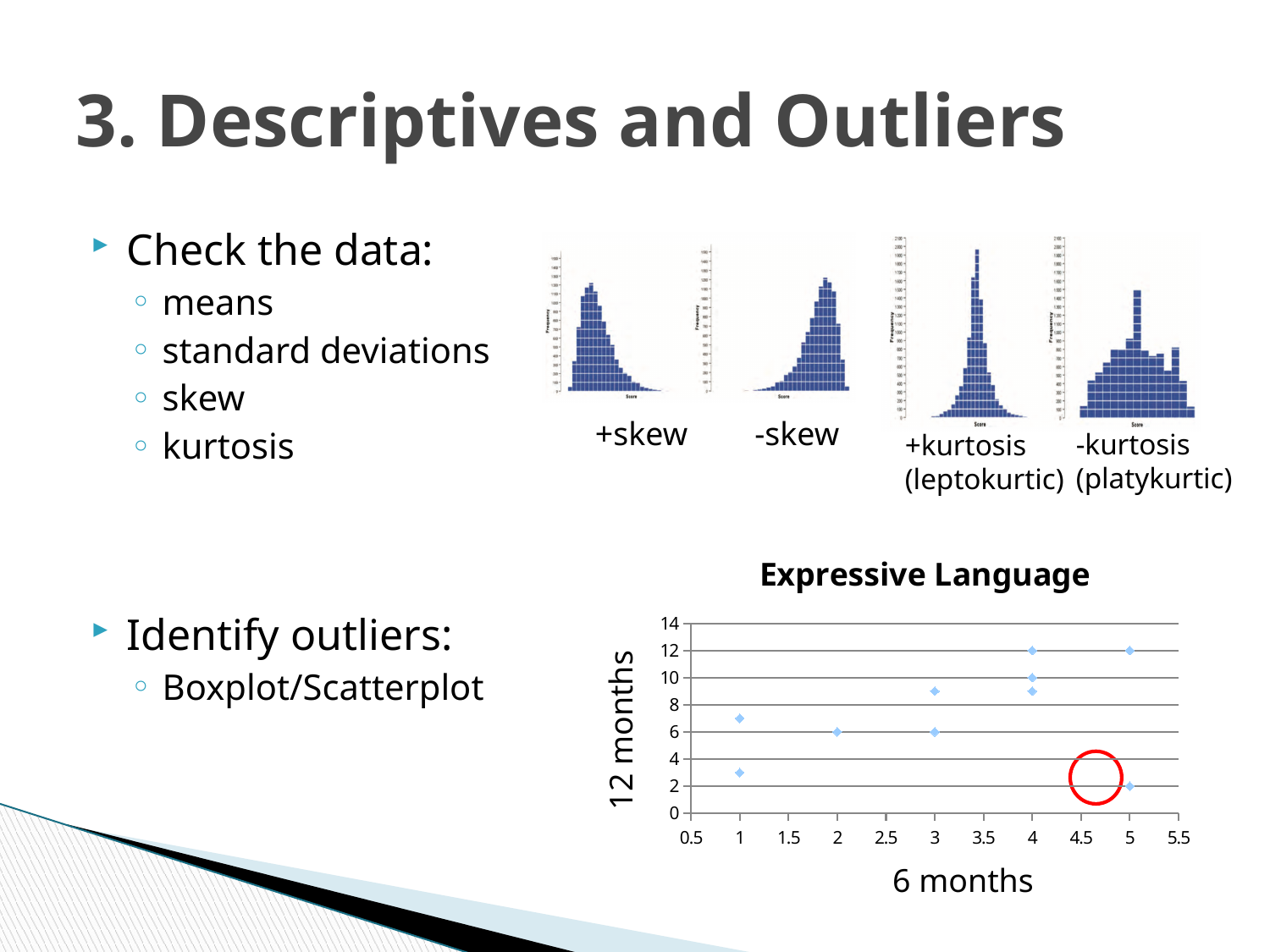
In the 'Expressive Language' chart, what is the difference between the two 12 months values plotted at 6 months = 5? 10 In the 'Expressive Language' chart, what are the x-axis and y-axis labels? x-axis: 6 months; y-axis: 12 months How many data points are plotted in the 'Expressive Language' chart? 10 In the 'Expressive Language' chart, what is the highest 12 months value plotted? 12 In the 'Expressive Language' chart, what is the 12 months value of the single point at 6 months = 2? 6 In the 'Expressive Language' chart, which is larger: the 12 months value of the point at 6 months = 2 or the higher point at 6 months = 3? the higher point at 6 months = 3 In the 'Expressive Language' chart, what is the 12 months value of the lower point at 6 months = 5? 2 In the 'Expressive Language' chart, what is the lowest 12 months value plotted? 2 In the 'Expressive Language' chart, how many points have a 6 months value of 4? 3 What kind of chart is the 'Expressive Language' chart? scatter chart What is the title of the chart at the bottom right of the slide? Expressive Language In the 'Expressive Language' chart, is the 12 months value of the higher point at 6 months = 1 greater or less than 6? greater